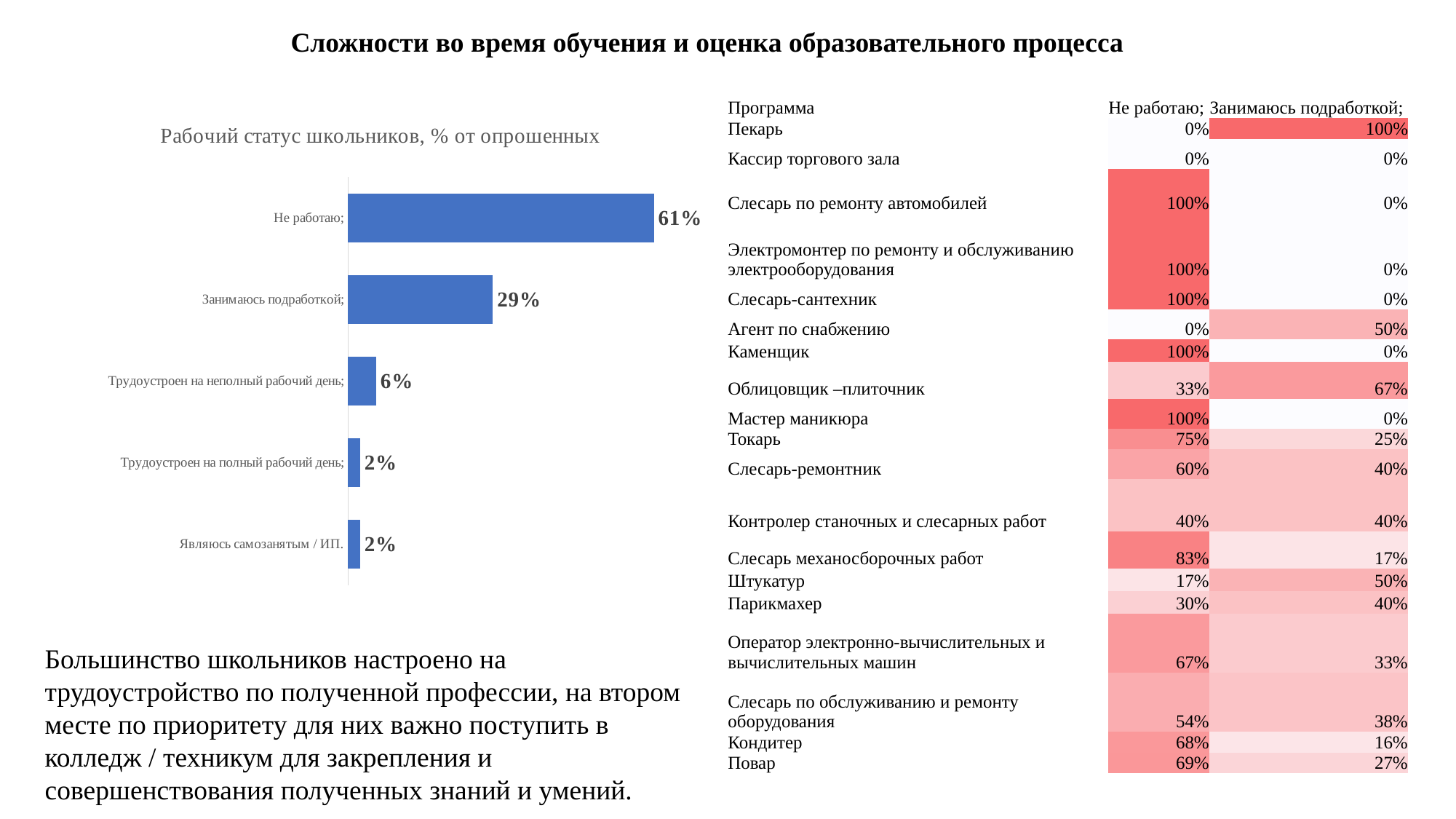
What type of chart is shown on the slide? bar chart Which category has the highest value? Не работаю Which is larger: the value for "Занимаюсь подработкой" or the value for "Трудоустроен на неполный рабочий день"? Занимаюсь подработкой What is the difference between the values for "Занимаюсь подработкой" and "Трудоустроен на неполный рабочий день"? 23% What is the value for "Являюсь самозанятым / ИП."? 2% What is the value for "Трудоустроен на полный рабочий день"? 2% What is the difference between the values for "Не работаю" and "Занимаюсь подработкой"? 32% What is the value for "Занимаюсь подработкой"? 29% What is the value for "Трудоустроен на неполный рабочий день"? 6% What is the title of the chart on the slide? Рабочий статус школьников, % от опрошенных What is the value for "Не работаю"? 61% How many categories are shown in the bar chart? 5